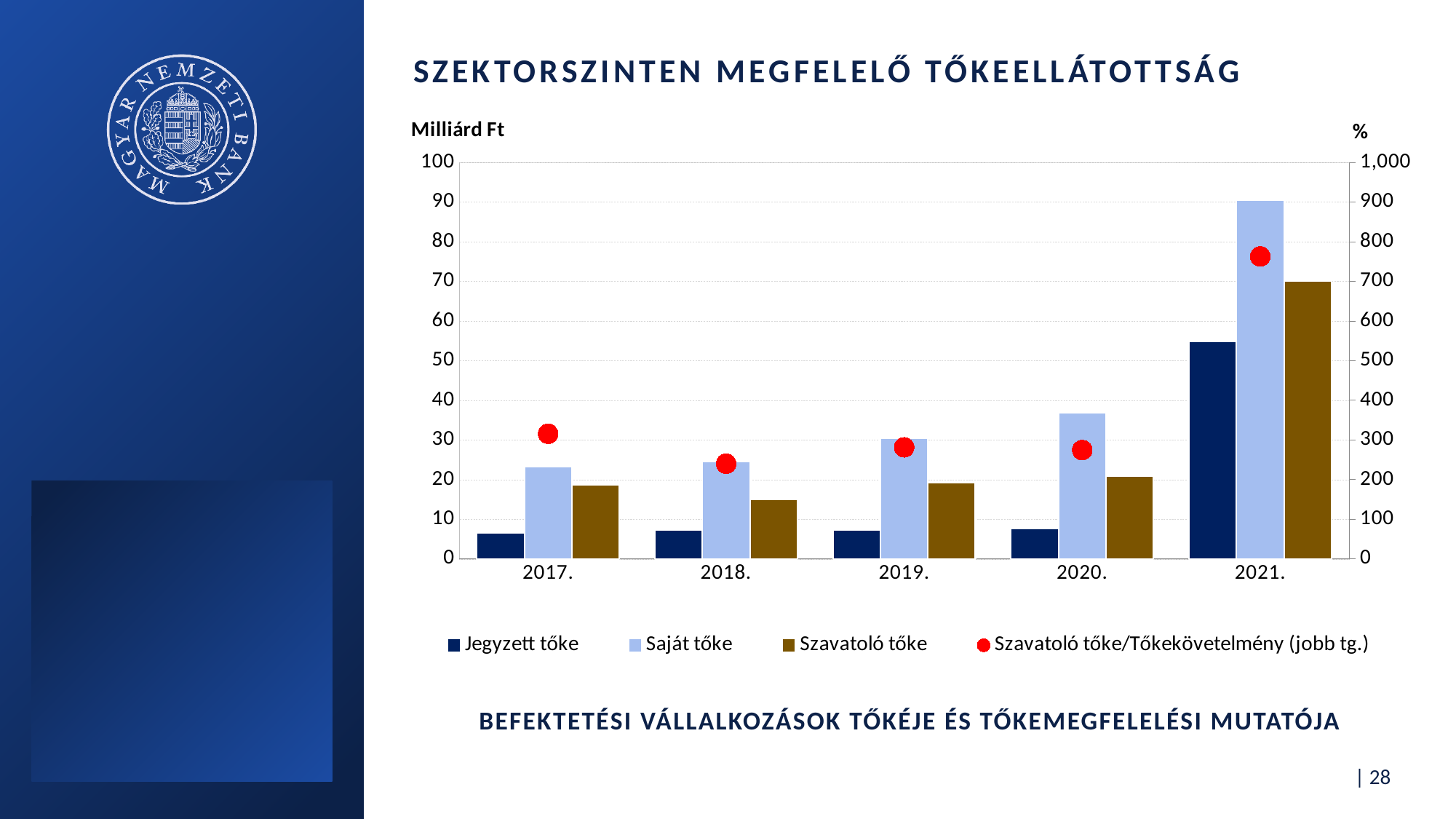
In which year is Saját tőke highest? 2021. Is the value for Saját tőke in 2021. greater or less than 80? greater How many series does the legend list? 4 Is the value for Jegyzett tőke in 2021. greater or less than 50? greater In which year is Szavatoló tőke lowest? 2018. In which year is Szavatoló tőke/Tőkekövetelmény (jobb tg.) highest? 2021. How many years are shown on the x axis? 5 What unit is shown on the left axis? Milliárd Ft What kind of chart is shown on the slide? bar chart with a marker series Is the value for Szavatoló tőke in 2017. greater or less than 20? less Does Saját tőke rise or fall from 2017. to 2021.? rises Which is larger, Saját tőke in 2019. or Saját tőke in 2020.? 2020.